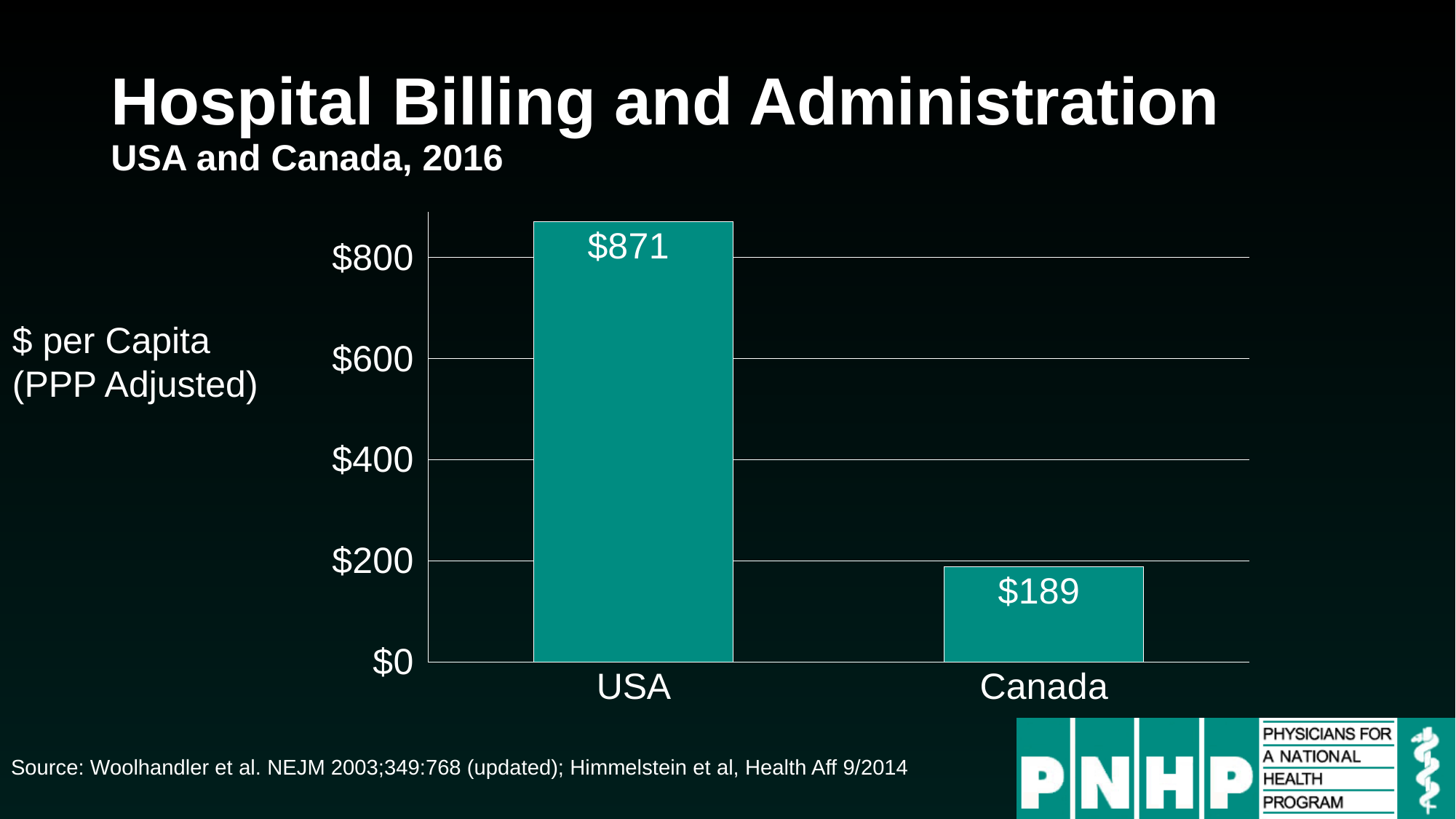
Is the value for the USA larger or smaller than the value for Canada? larger What is the label on the vertical axis of the chart? $ per Capita (PPP Adjusted) What is the hospital billing and administration cost per capita for Canada? $189 Is the value for Canada greater or less than $200? less How many countries are shown in the chart? 2 What year does the chart's data refer to? 2016 What is the difference between the USA and Canada values? $682 What kind of chart is shown on the slide? bar chart What is the hospital billing and administration cost per capita for the USA? $871 Which country has the higher hospital billing and administration cost per capita? USA Is the value for the USA greater or less than $800? greater Which country has the lower hospital billing and administration cost per capita? Canada